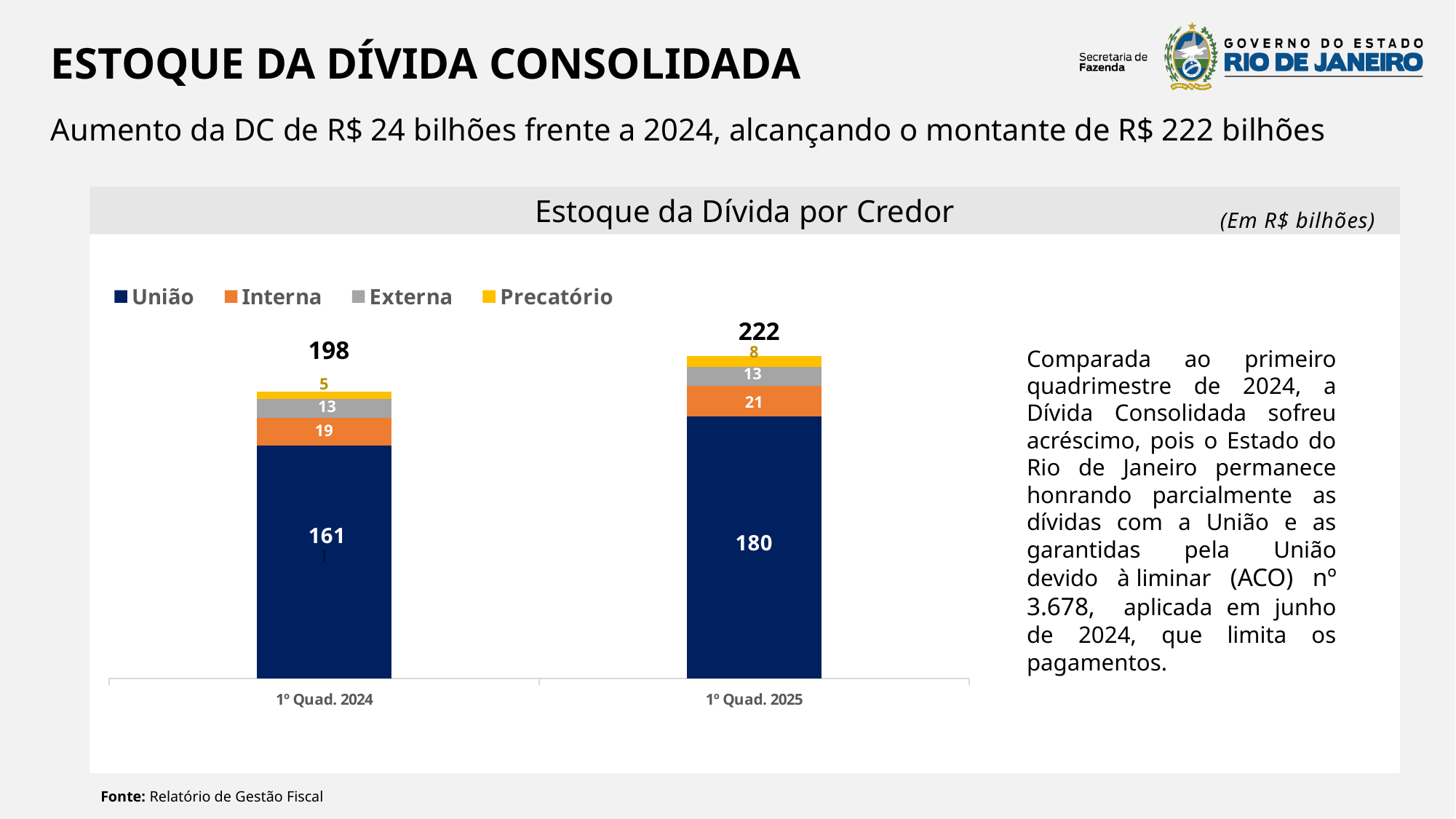
Which is larger, Interna in 1º Quad. 2024 or Interna in 1º Quad. 2025? 1º Quad. 2025 What is the total of the stacked bar for 1º Quad. 2025? 222 What is the title of the chart? Estoque da Dívida por Credor What is the value of Externa for 1º Quad. 2025? 13 What is the difference between the União values for 1º Quad. 2025 and 1º Quad. 2024? 19 What is the value of Precatório for 1º Quad. 2024? 5 What is the total of the stacked bar for 1º Quad. 2024? 198 Which series has the smallest value in 1º Quad. 2025? Precatório What is the value of Interna for 1º Quad. 2025? 21 How many series does the legend list? 4 What is the value of União for 1º Quad. 2024? 161 What kind of chart is shown? Stacked bar chart